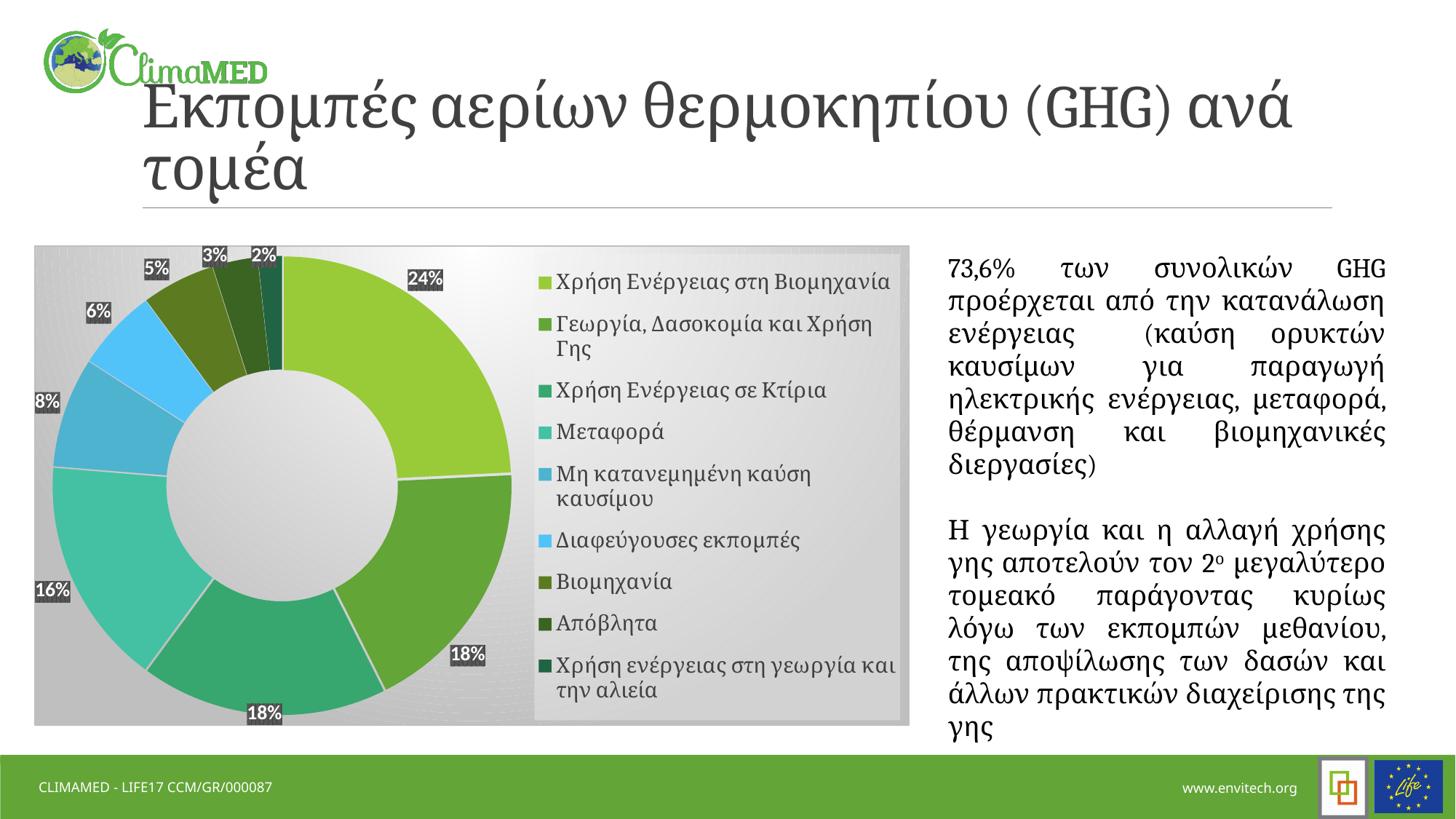
How many categories does the chart's legend list? 9 Which category has the largest share of the chart? Χρήση Ενέργειας στη Βιομηχανία Which category has the smallest share of the chart? Χρήση ενέργειας στη γεωργία και την αλιεία What percentage is shown for Χρήση Ενέργειας στη Βιομηχανία? 24% What percentage is shown for Χρήση ενέργειας στη γεωργία και την αλιεία? 2% What percentage is shown for Μη κατανεμημένη καύση καυσίμου? 8% What percentage is shown for Απόβλητα? 3% Which is larger, the share for Διαφεύγουσες εκπομπές or the share for Βιομηχανία? Διαφεύγουσες εκπομπές What type of chart is shown on the slide? Doughnut (pie) chart Which legend entry is listed first in the chart's legend? Χρήση Ενέργειας στη Βιομηχανία What is the difference in percentage points between Χρήση Ενέργειας στη Βιομηχανία and Μεταφορά? 8 percentage points What percentage is shown for Μεταφορά? 16%